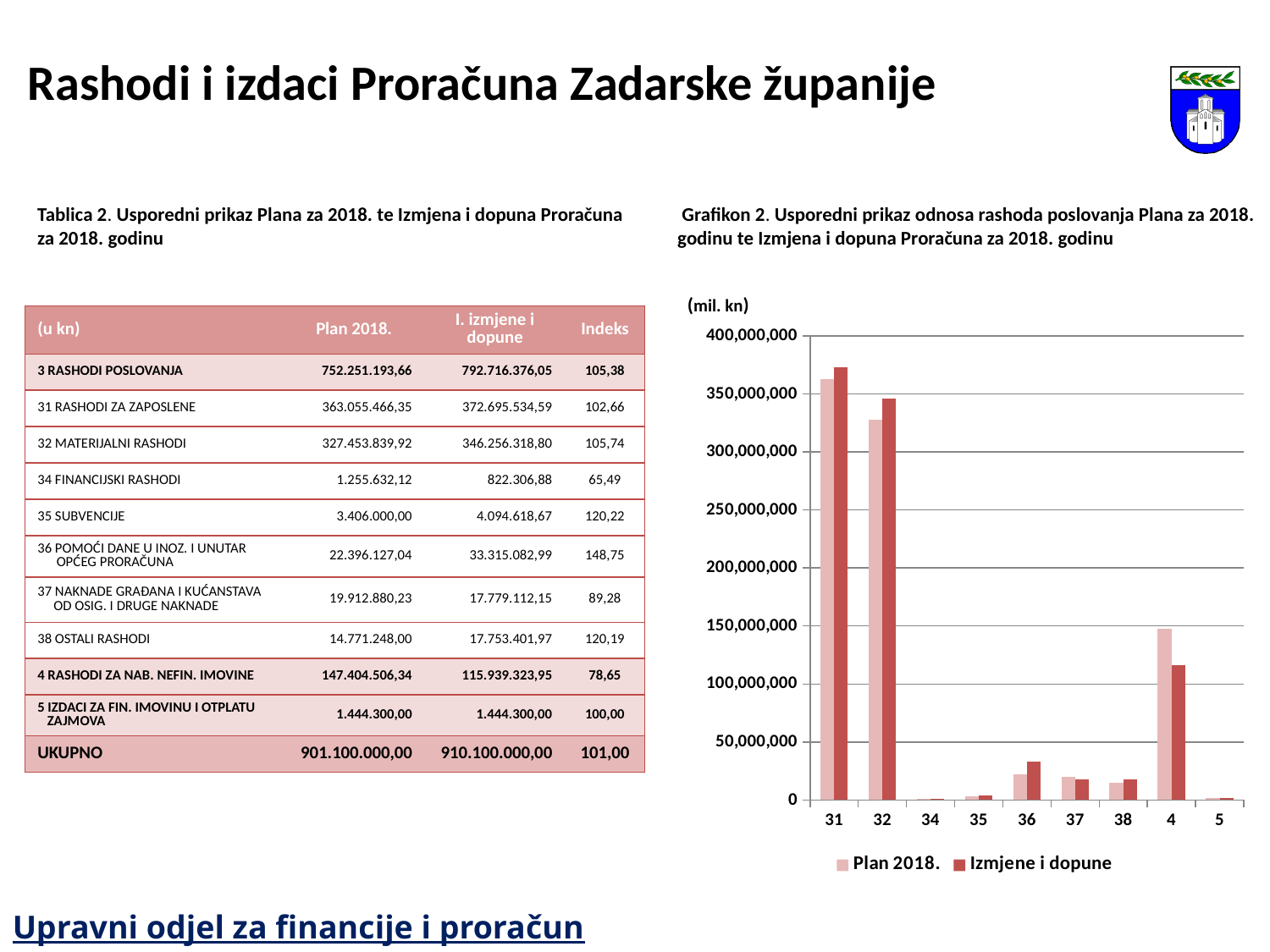
In Grafikon 2, is the Izmjene i dopune value for category 36 greater or less than 50,000,000? less In Grafikon 2, is the Plan 2018. value for category 31 greater or less than 350,000,000? greater In Grafikon 2, for category 32, which series has the larger value: Plan 2018. or Izmjene i dopune? Izmjene i dopune What are the two legend entries of Grafikon 2? Plan 2018. and Izmjene i dopune What kind of chart is Grafikon 2 on the slide? bar chart How many series does the legend of Grafikon 2 list? 2 In Grafikon 2, is the Plan 2018. value for category 32 greater or less than 300,000,000? greater In Grafikon 2, which category has the highest value for the Plan 2018. series? 31 How many categories are shown on the x axis of Grafikon 2? 9 In Grafikon 2, which category has the highest value for the Izmjene i dopune series? 31 In Grafikon 2, for category 4, which series has the larger value: Plan 2018. or Izmjene i dopune? Plan 2018.